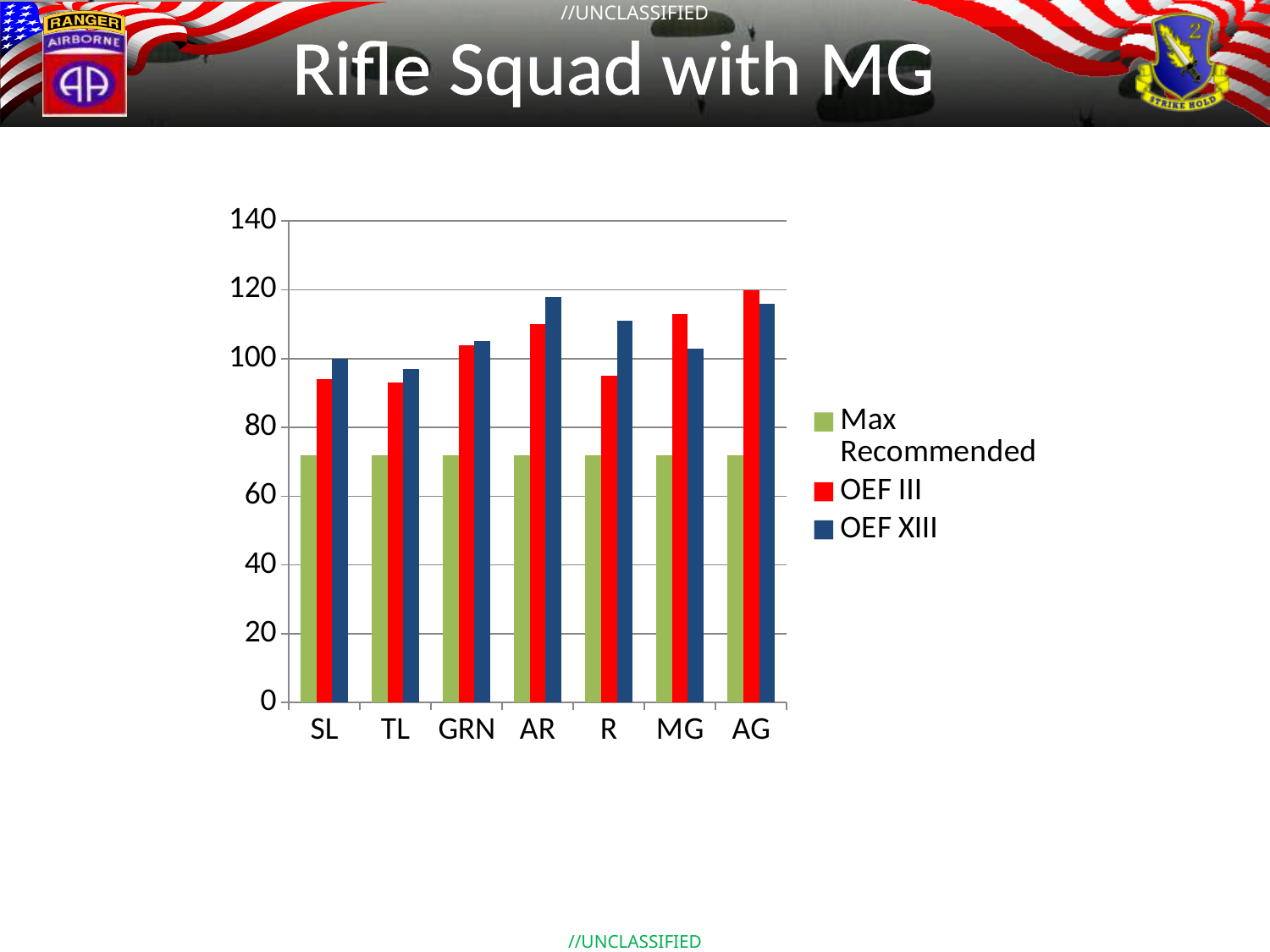
How many categories are shown on the x axis of the chart? 7 Is the Max Recommended value for SL greater or less than 80? less Is the OEF III value for AG greater or less than 100? greater What is the title of the slide containing the chart? Rifle Squad with MG For R, which is larger: the OEF III value or the OEF XIII value? OEF XIII How many series does the chart's legend list? 3 Is the OEF III value for TL greater or less than 100? less Do the Max Recommended values rise, fall, or stay flat across the categories? stay flat For MG, which is larger: the OEF III value or the OEF XIII value? OEF III Which category has the highest OEF III value? AG What kind of chart is shown on the slide? bar chart